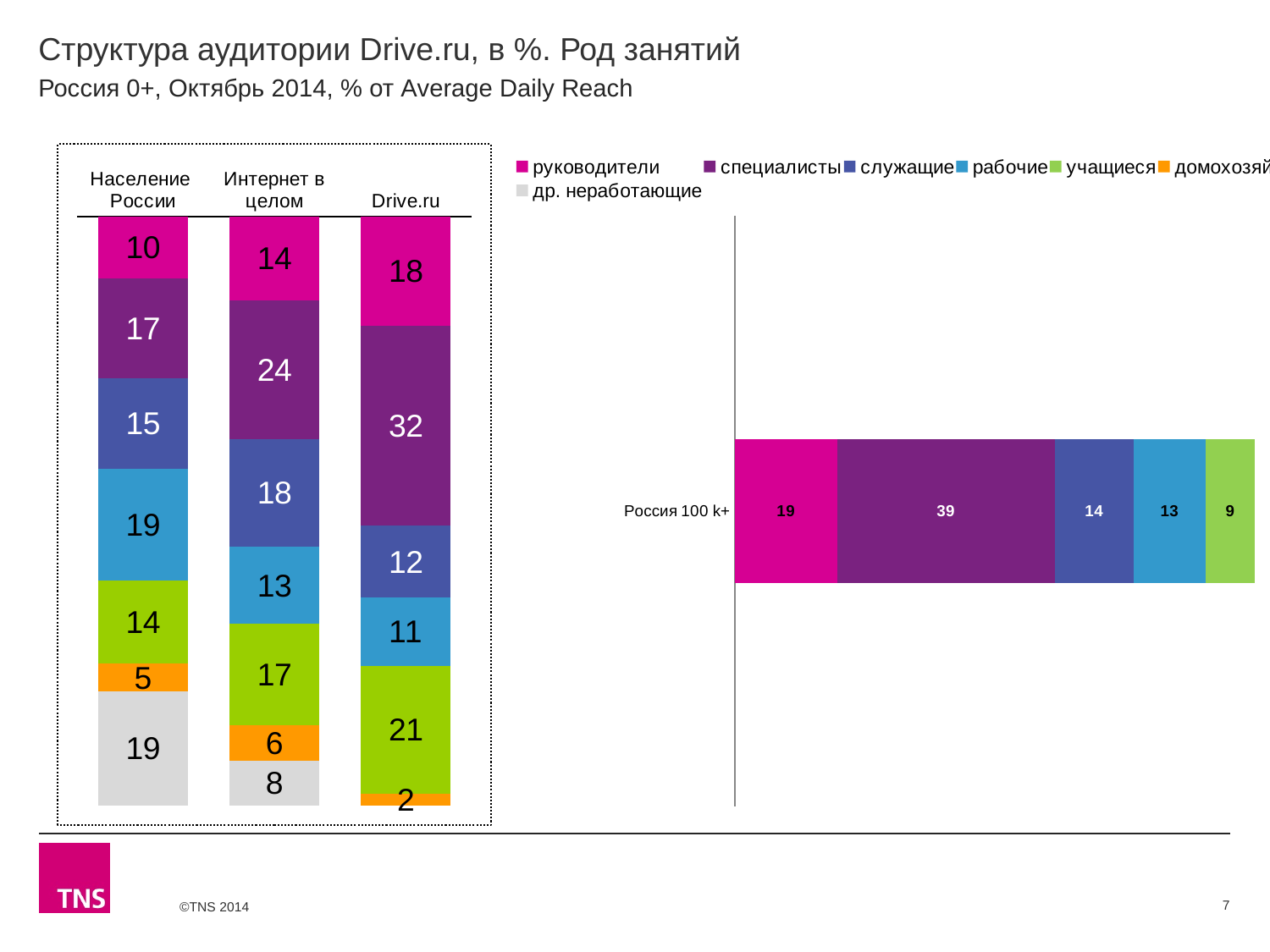
In the left chart, which is larger: the рабочие value for Население России or for Drive.ru? Население России What kind of chart is the chart on the right? stacked bar chart In the left chart, which segment is the smallest in the Drive.ru bar? домохозяйки In the left chart, what is the value for учащиеся in the Интернет в целом bar? 17 In the right chart, what is the value for специалисты in the Россия 100 k+ bar? 39 In the left chart, what is the value for специалисты in the Drive.ru bar? 32 In the left chart, which segment is the largest in the Drive.ru bar? специалисты How many series does the legend list? 7 In the left chart, what is the value for руководители in the Население России bar? 10 In the left chart, what is the difference between the специалисты values for Drive.ru and Население России? 15 In the left chart, how many bars (audience groups) are shown? 3